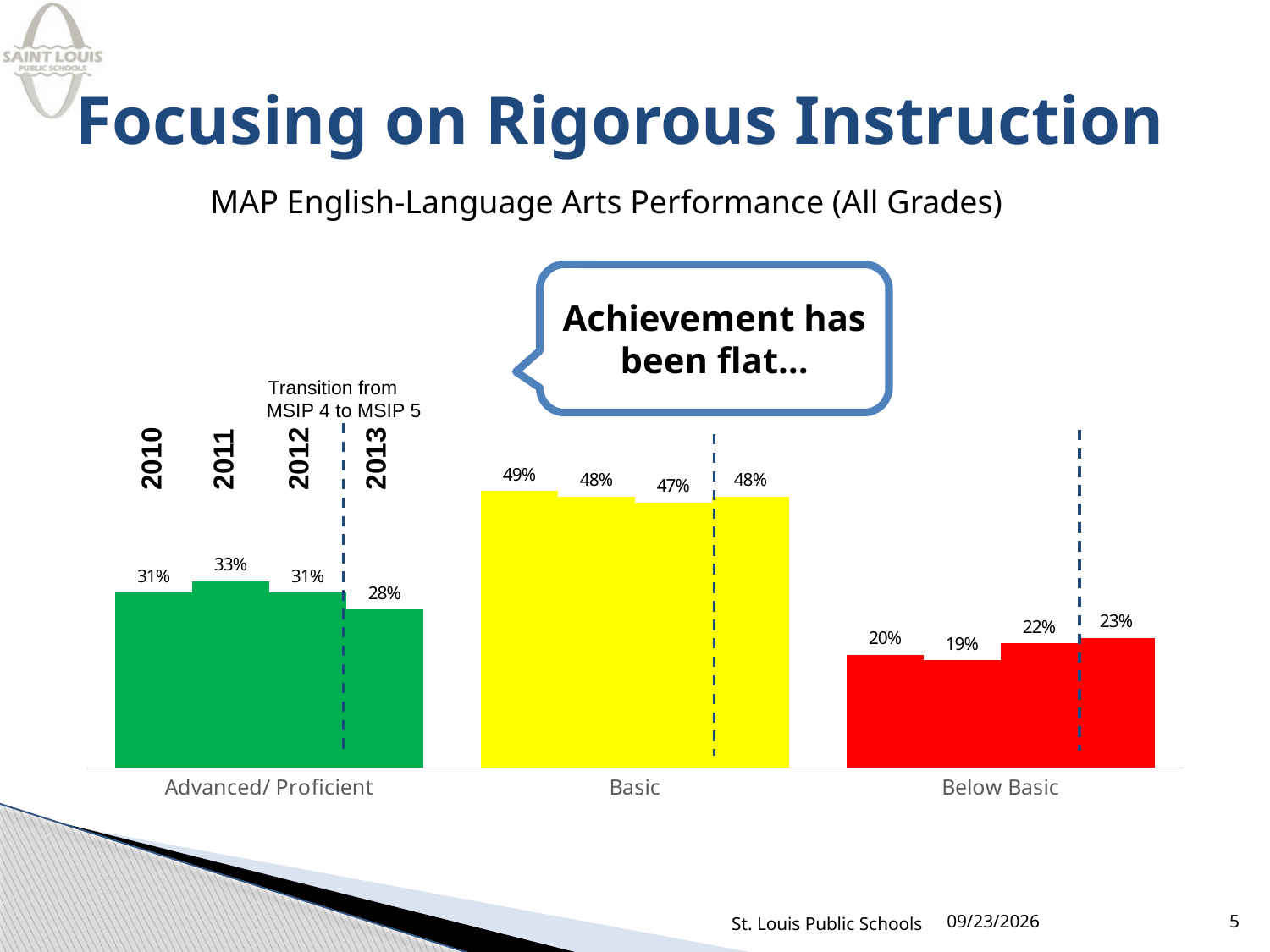
How many years are plotted for each performance category? 4 Which is larger: the Below Basic percentage in 2010 or in 2013? 2013 What colour are the bars for the Basic category? Yellow What kind of chart is shown on the slide? Bar chart What was the Basic percentage in 2010? 49% How many performance categories are shown on the x axis? 3 What was the Advanced/Proficient percentage in 2013? 28% In which year was the Advanced/Proficient percentage highest? 2011 What is the difference between the Advanced/Proficient percentage in 2011 and in 2013? 5% From 2010 to 2013, did the Below Basic percentage generally rise or fall? Rise What was the Below Basic percentage in 2012? 22% In which year was the Below Basic percentage lowest? 2011